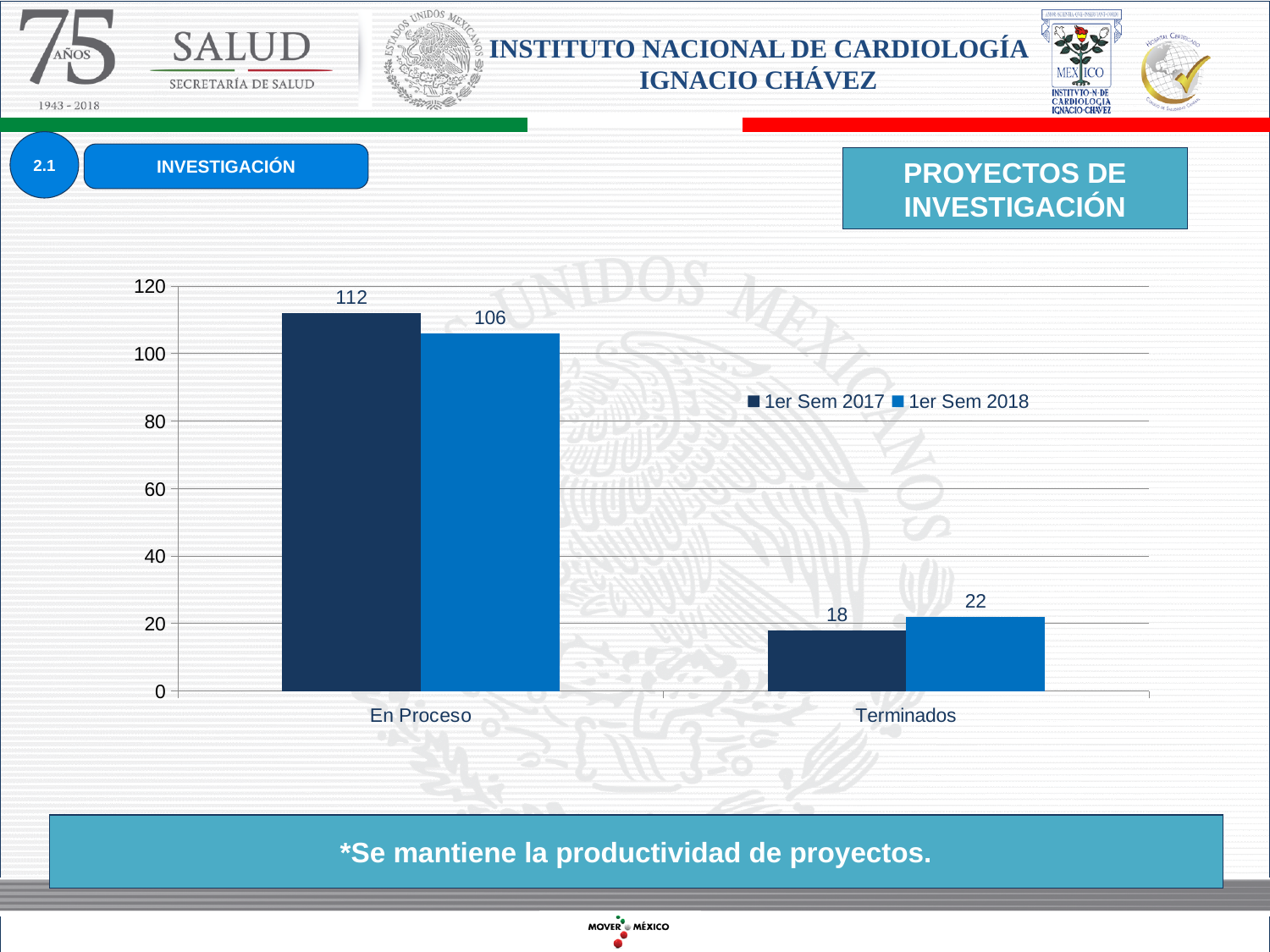
What is the difference between the 1er Sem 2018 and 1er Sem 2017 values for Terminados? 4 How many categories are shown on the x axis? 2 For Terminados, which series has the larger value, 1er Sem 2017 or 1er Sem 2018? 1er Sem 2018 What is the value for En Proceso in the 1er Sem 2017 series? 112 How many series does the legend list? 2 Which category has the lowest value in the 1er Sem 2018 series? Terminados What is the value for Terminados in the 1er Sem 2018 series? 22 What kind of chart is shown on the slide? Bar chart Which category has the highest value in the 1er Sem 2017 series? En Proceso What is the value for Terminados in the 1er Sem 2017 series? 18 What is the value for En Proceso in the 1er Sem 2018 series? 106 What is the difference between the 1er Sem 2017 and 1er Sem 2018 values for En Proceso? 6